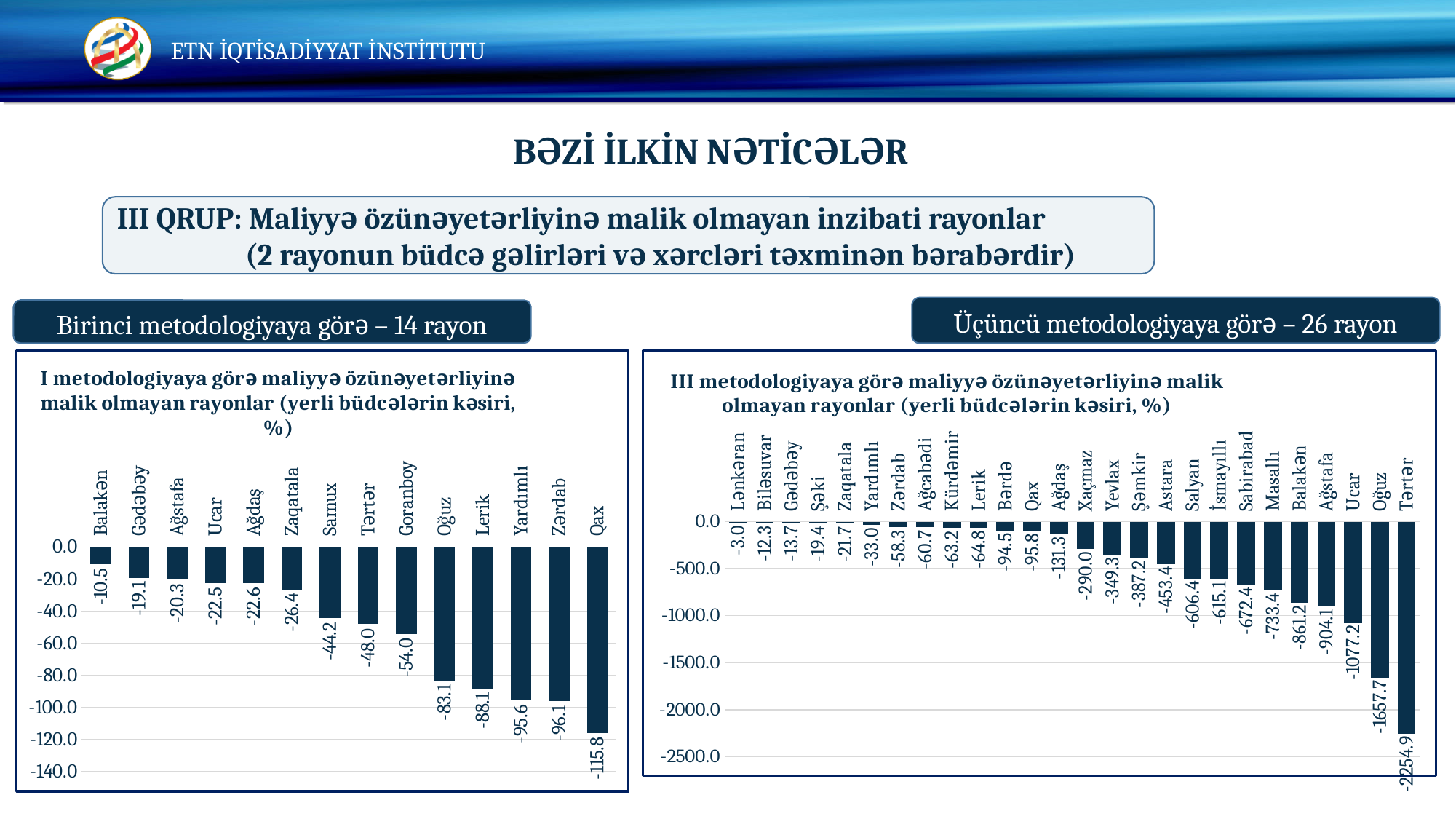
What type of chart is the left chart (I metodologiyaya görə)? Bar chart In the left chart (I metodologiyaya görə), what is the value for Qax? -115.8 In the right chart (III metodologiyaya görə), which rayon has the most negative value? Tərtər In the right chart (III metodologiyaya görə), what is the difference between the values for Tərtər and Oğuz? 597.2 In the left chart (I metodologiyaya görə), which rayon has the lowest (most negative) value? Qax In the right chart (III metodologiyaya görə), what is the value for Xaçmaz? -290.0 In the right chart (III metodologiyaya görə), what is the value for Ucar? -1077.2 In the right chart (III metodologiyaya görə), how many rayons are plotted? 26 In the left chart (I metodologiyaya görə), which has the more negative value, Tərtər or Zaqatala? Tərtər In the left chart (I metodologiyaya görə), what is the difference between the values for Oğuz and Goranboy? 29.1 In the left chart (I metodologiyaya görə), what is the value for Samux? -44.2 In the left chart (I metodologiyaya görə), how many rayons are plotted? 14